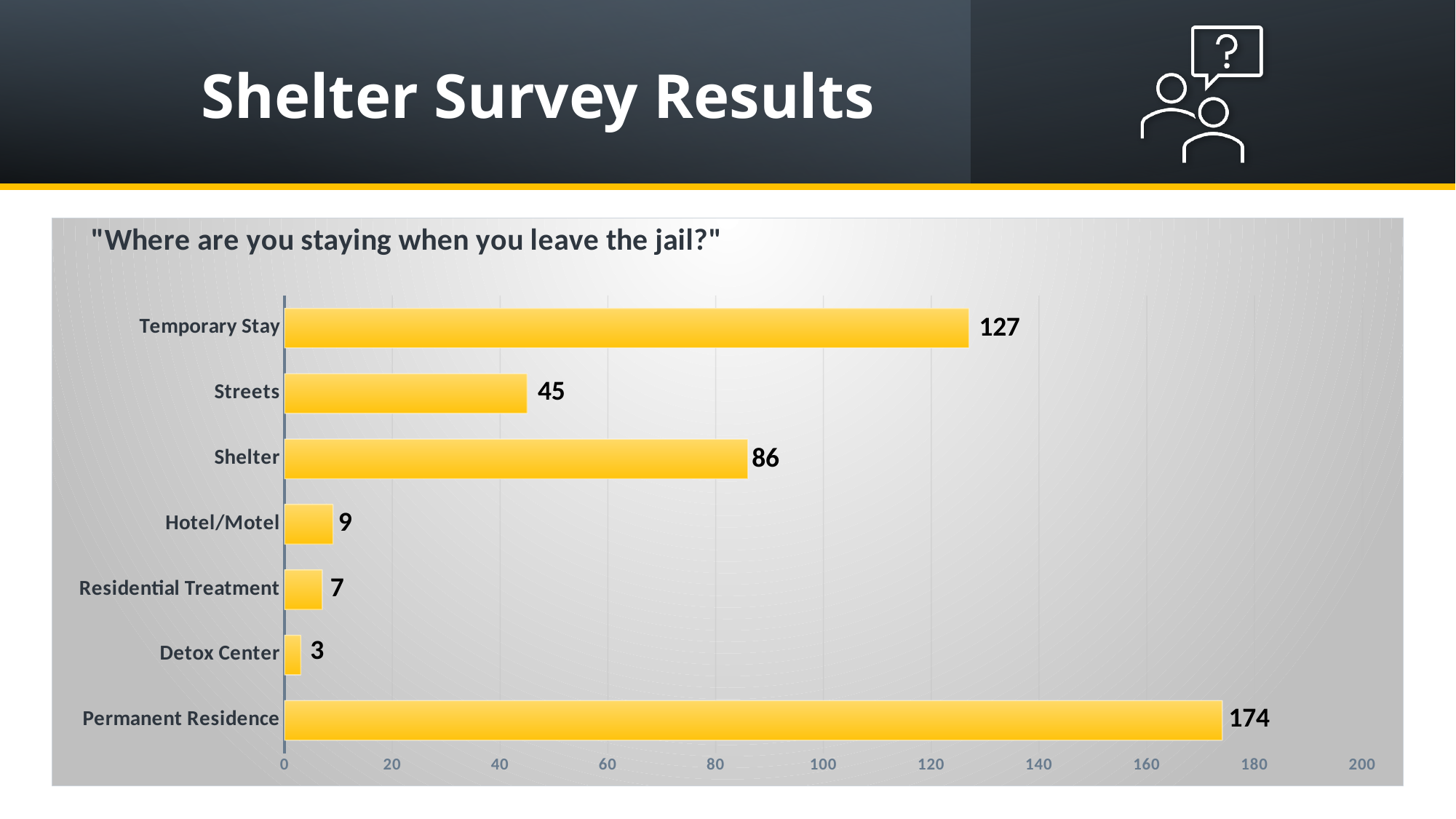
What is the value for Detox Center? 3 How many categories are shown in the chart? 7 Which is larger, the value for Hotel/Motel or the value for Residential Treatment? Hotel/Motel Which category has the highest value? Permanent Residence What is the value for Shelter? 86 What is the value for Temporary Stay? 127 Which category has the lowest value? Detox Center What is the difference between the values for Permanent Residence and Temporary Stay? 47 What kind of chart is shown on the slide? bar chart What is the difference between the values for Shelter and Streets? 41 Is the value for Streets greater or less than 40? greater What is the title of the chart? "Where are you staying when you leave the jail?"